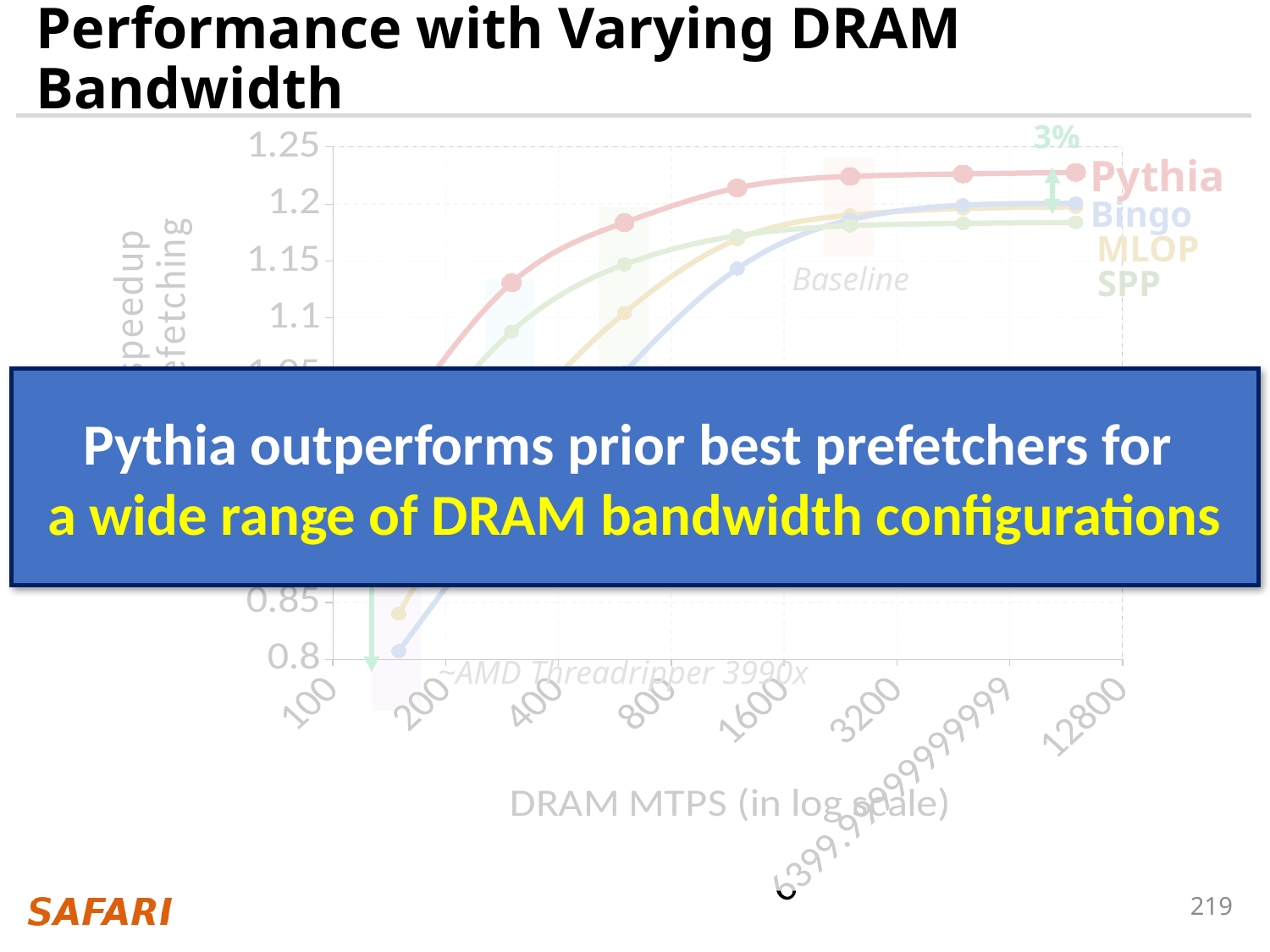
Which series has the lowest speedup at the right end of the chart (12800 DRAM MTPS)? SPP Is the value for Pythia at 400 DRAM MTPS greater or less than 1.1? greater How many series (prefetchers) are labelled on the chart? 4 What is the title of the x axis? DRAM MTPS (in log scale) Do the speedup values rise or fall as DRAM MTPS increases along the x axis? rise At 1600 DRAM MTPS, which is larger, the value for Pythia or the value for Bingo? Pythia What percentage is annotated above the Pythia line at the right end of the chart? 3% Is the value for Pythia at 12800 DRAM MTPS greater or less than 1.2? greater Is the value for SPP at 12800 DRAM MTPS greater or less than 1.2? less What kind of chart is shown on the slide? line chart Which series has the highest speedup at the right end of the chart (12800 DRAM MTPS)? Pythia